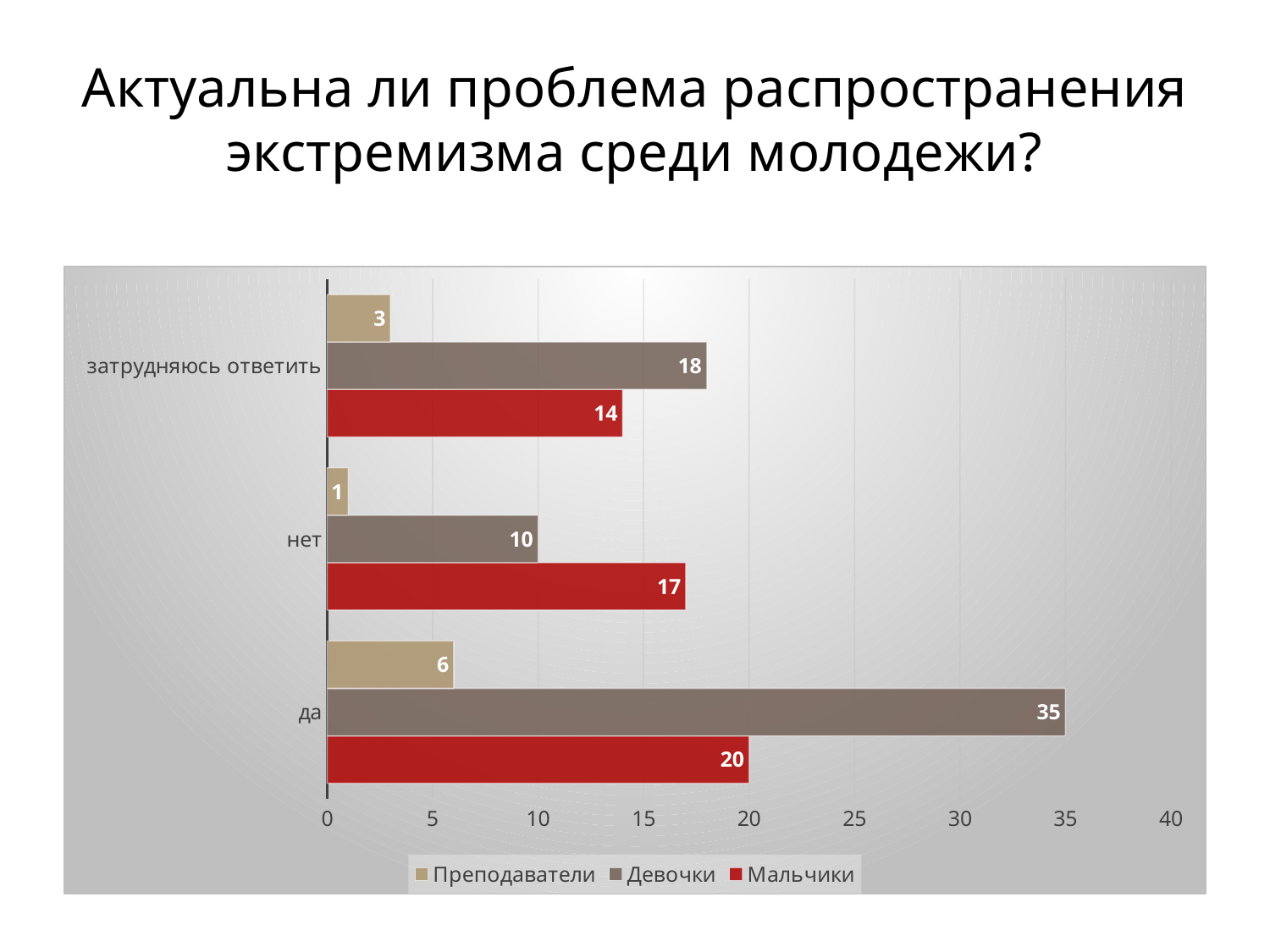
In the category нет, which series has the larger value, Девочки or Мальчики? Мальчики What kind of chart is shown on the slide? bar chart What is the value for Мальчики in the category нет? 17 What is the value for Девочки in the category да? 35 What is the total of the three series values in the category затрудняюсь ответить? 35 Which category has the lowest value for Преподаватели? нет How many categories are shown on the chart? 3 What is the value for Преподаватели in the category затрудняюсь ответить? 3 What is the difference between the Девочки and Мальчики values in the category да? 15 Which category has the highest value for Мальчики? да Which series is shown in red on the chart? Мальчики How many series does the legend list? 3